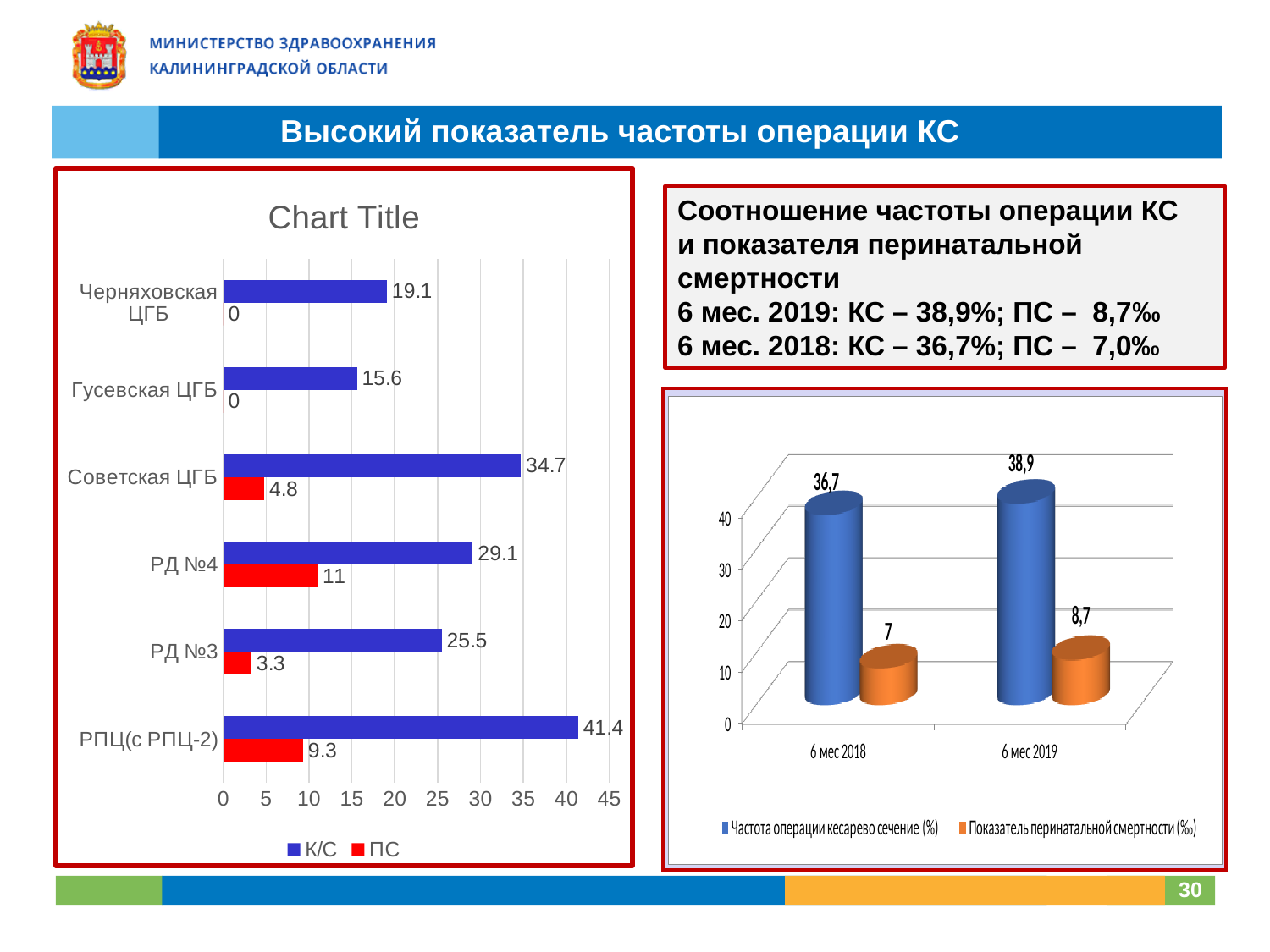
In the left chart titled "Chart Title", which category has the lowest К/С value? Гусевская ЦГБ In the left chart titled "Chart Title", which is larger: the К/С value for РД №4 or for РД №3? РД №4 In the right chart, what is the value of Частота операции кесарево сечение (%) for 6 мес 2019? 38,9 In the right chart, what is the value of Показатель перинатальной смертности (‰) for 6 мес 2018? 7 In the left chart titled "Chart Title", how many series does the legend list? 2 In the left chart titled "Chart Title", what is the К/С value for РПЦ(с РПЦ-2)? 41.4 In the right chart, what is the difference in Частота операции кесарево сечение (%) between 6 мес 2019 and 6 мес 2018? 2,2 What type of chart is the left chart titled "Chart Title"? Bar chart In the left chart titled "Chart Title", what is the difference between the К/С and ПС values for Советская ЦГБ? 29.9 In the left chart titled "Chart Title", what is the ПС value for РД №4? 11 In the left chart titled "Chart Title", how many categories are shown on the vertical axis? 6 In the left chart titled "Chart Title", which category has the highest К/С value? РПЦ(с РПЦ-2)